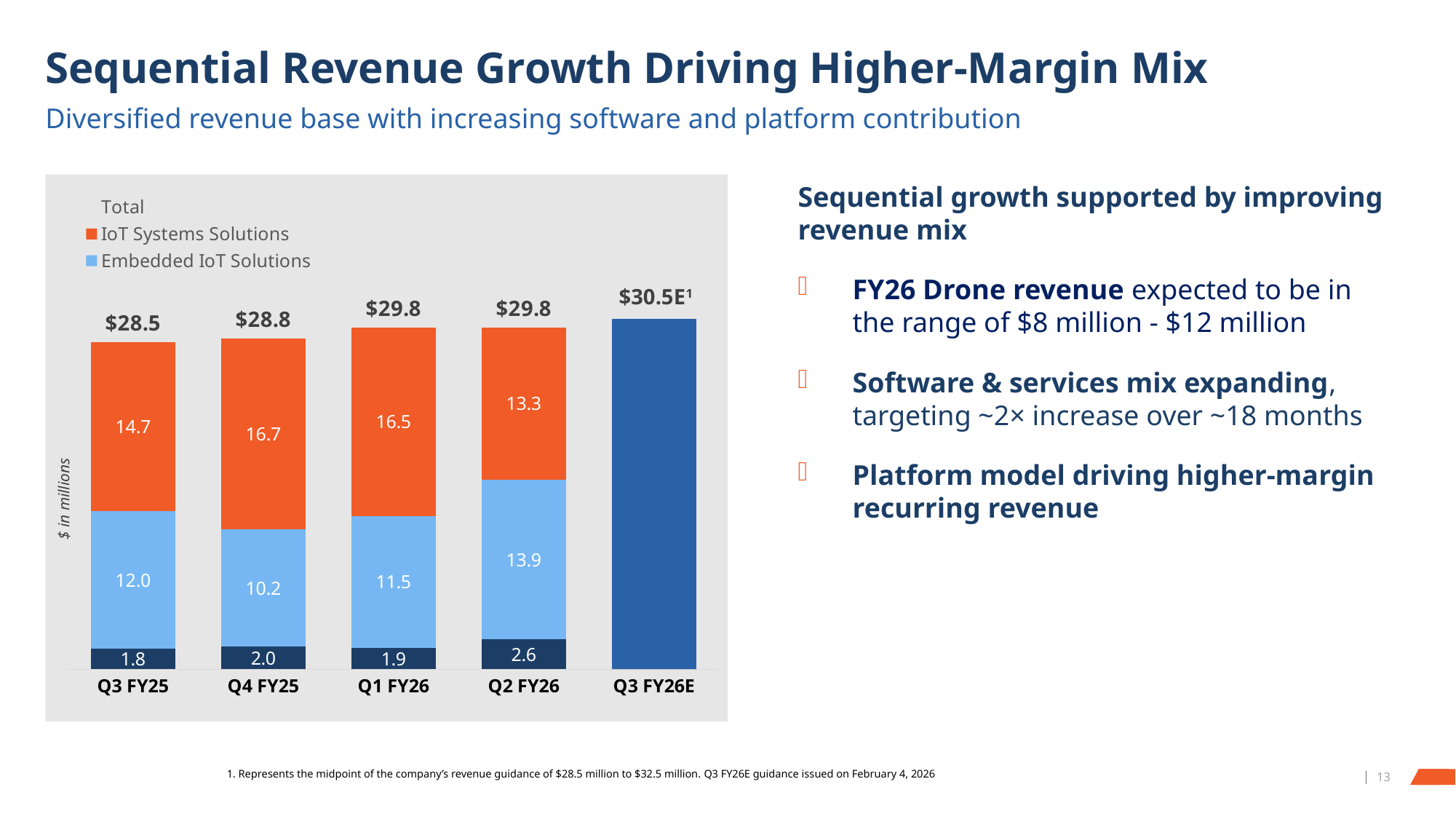
What kind of chart is shown on the slide? Stacked bar chart Which quarter has the highest Embedded IoT Solutions value? Q2 FY26 Which quarter has the highest IoT Systems Solutions value? Q4 FY25 What is the Embedded IoT Solutions value for Q2 FY26? 13.9 What total is shown above the Q3 FY25 bar? $28.5 Do the total values rise or fall from Q3 FY25 to Q3 FY26E? Rise How many quarters are shown on the x axis of the chart? 5 What is the difference between the IoT Systems Solutions values for Q1 FY26 and Q2 FY26? 3.2 Which quarter has the lowest Embedded IoT Solutions value? Q4 FY25 What is the IoT Systems Solutions value for Q4 FY25? 16.7 In Q3 FY25, which is larger: IoT Systems Solutions or Embedded IoT Solutions? IoT Systems Solutions What total is shown above the Q3 FY26E bar? $30.5E